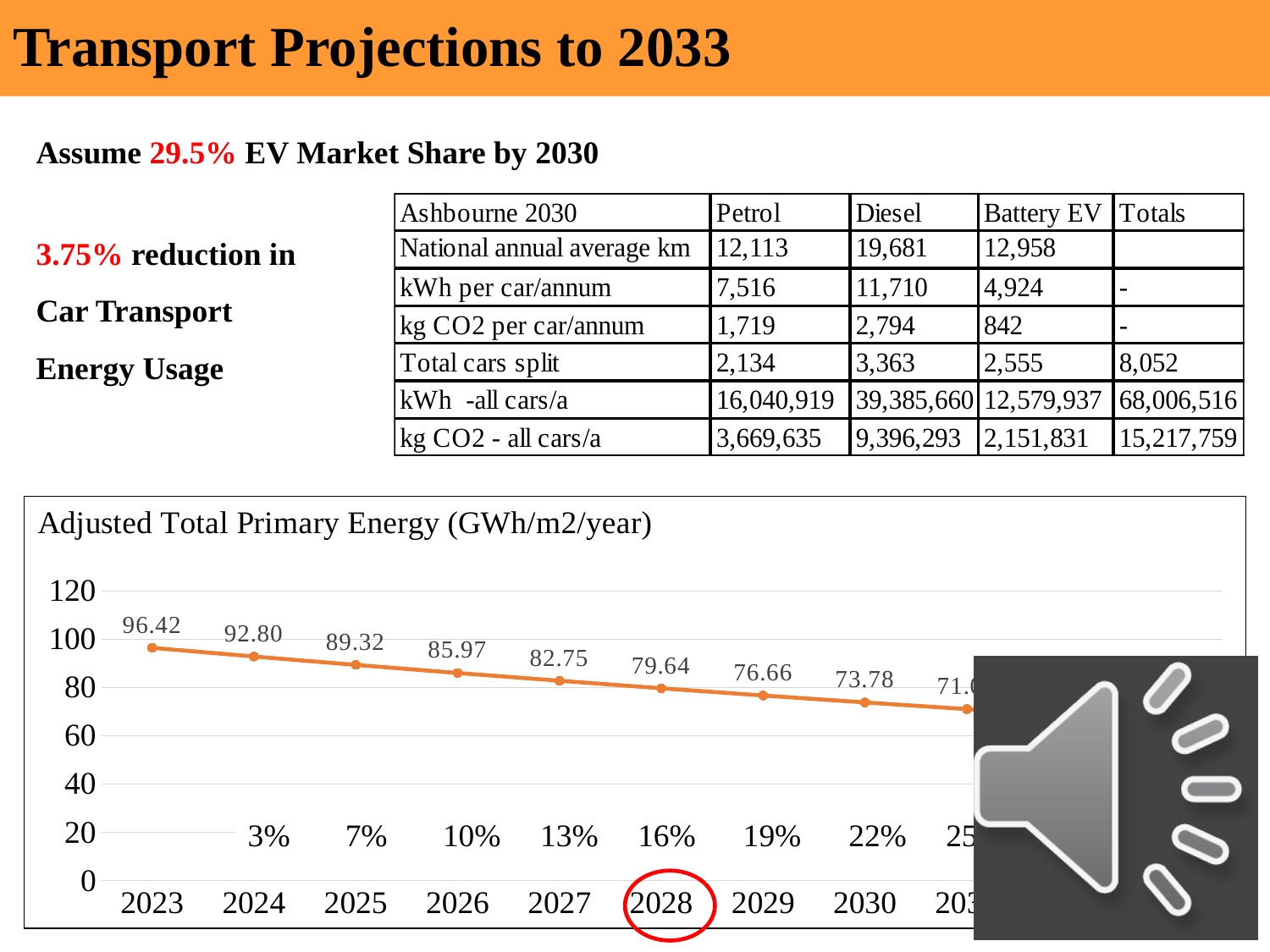
Do the values in the Adjusted Total Primary Energy chart rise or fall from 2023 to 2030? fall What is the difference between the values for 2023 and 2024 in the Adjusted Total Primary Energy chart? 3.62 Is the value for 2029 in the Adjusted Total Primary Energy chart greater or less than 80? less What is the value for 2026 in the Adjusted Total Primary Energy chart? 85.97 What is the value for 2030 in the Adjusted Total Primary Energy chart? 73.78 Which year on the x axis of the Adjusted Total Primary Energy chart is circled in red? 2028 Which year has the highest value in the Adjusted Total Primary Energy chart? 2023 What kind of chart is the Adjusted Total Primary Energy chart? line chart What is the difference between the values for 2025 and 2029 in the Adjusted Total Primary Energy chart? 12.66 What is the value for 2023 in the Adjusted Total Primary Energy chart? 96.42 Which is larger in the Adjusted Total Primary Energy chart, the value for 2027 or the value for 2030? 2027 What is the value for 2028 in the Adjusted Total Primary Energy chart? 79.64